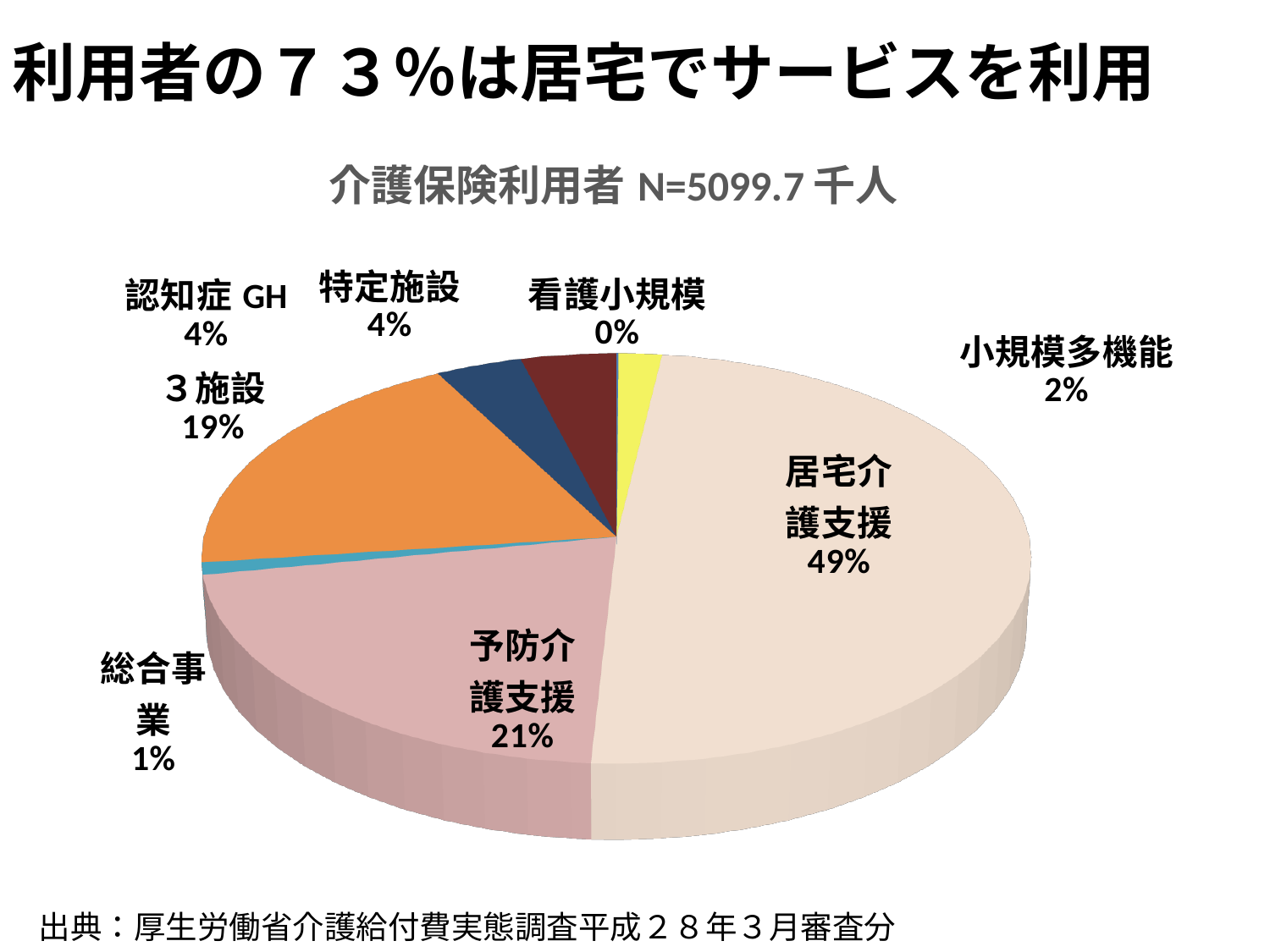
What percentage is shown for 3施設? 19% Which category has the smallest share of the pie? 看護小規模 What is the title of the chart? 介護保険利用者 N=5099.7 千人 What is the difference in percentage points between 居宅介護支援 and 予防介護支援? 28 Which category has the largest share of the pie? 居宅介護支援 What percentage is shown for 予防介護支援? 21% What percentage is shown for 小規模多機能? 2% What kind of chart is shown on the slide? Pie chart What share of the pie does 居宅介護支援 hold? 49% Which is larger, the share for 3施設 or the share for 予防介護支援? 予防介護支援 What percentage is shown for 看護小規模? 0% How many categories are shown in the pie chart? 8